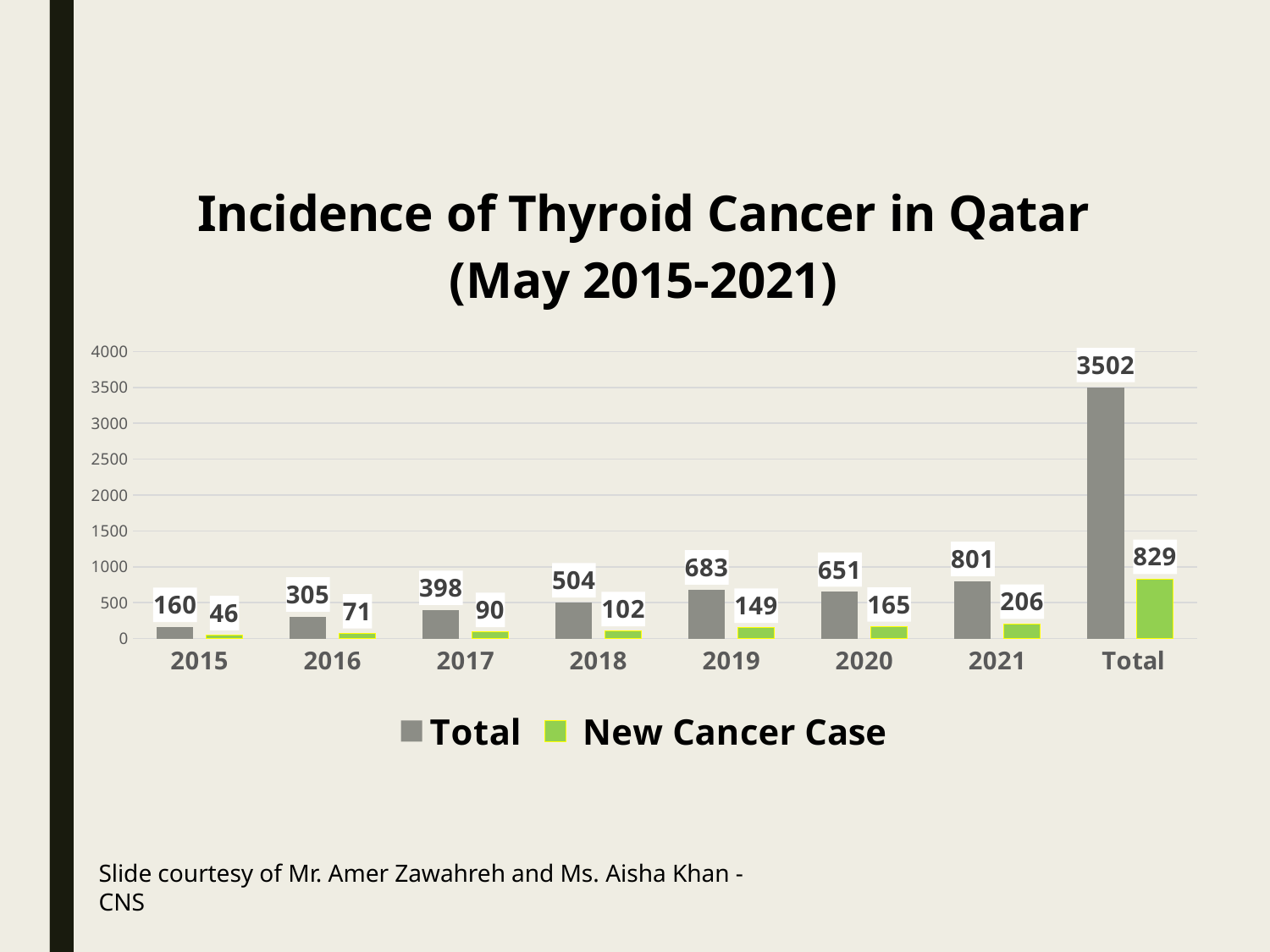
How many categories are shown on the x axis? 8 Is the Total value for 2021 greater or less than 500? greater Which is larger, the Total value for 2019 or the Total value for 2020? 2019 What kind of chart is shown on the slide? bar chart What is the New Cancer Case value for 2021? 206 How many series does the legend list? 2 What is the title of the chart? Incidence of Thyroid Cancer in Qatar (May 2015-2021) What is the Total value for the Total category? 3502 Among the years 2015 to 2021, which year has the lowest New Cancer Case value? 2015 Among the years 2015 to 2021, which year has the highest Total value? 2021 What is the difference between the Total value and the New Cancer Case value for 2018? 402 What is the Total value for 2019? 683